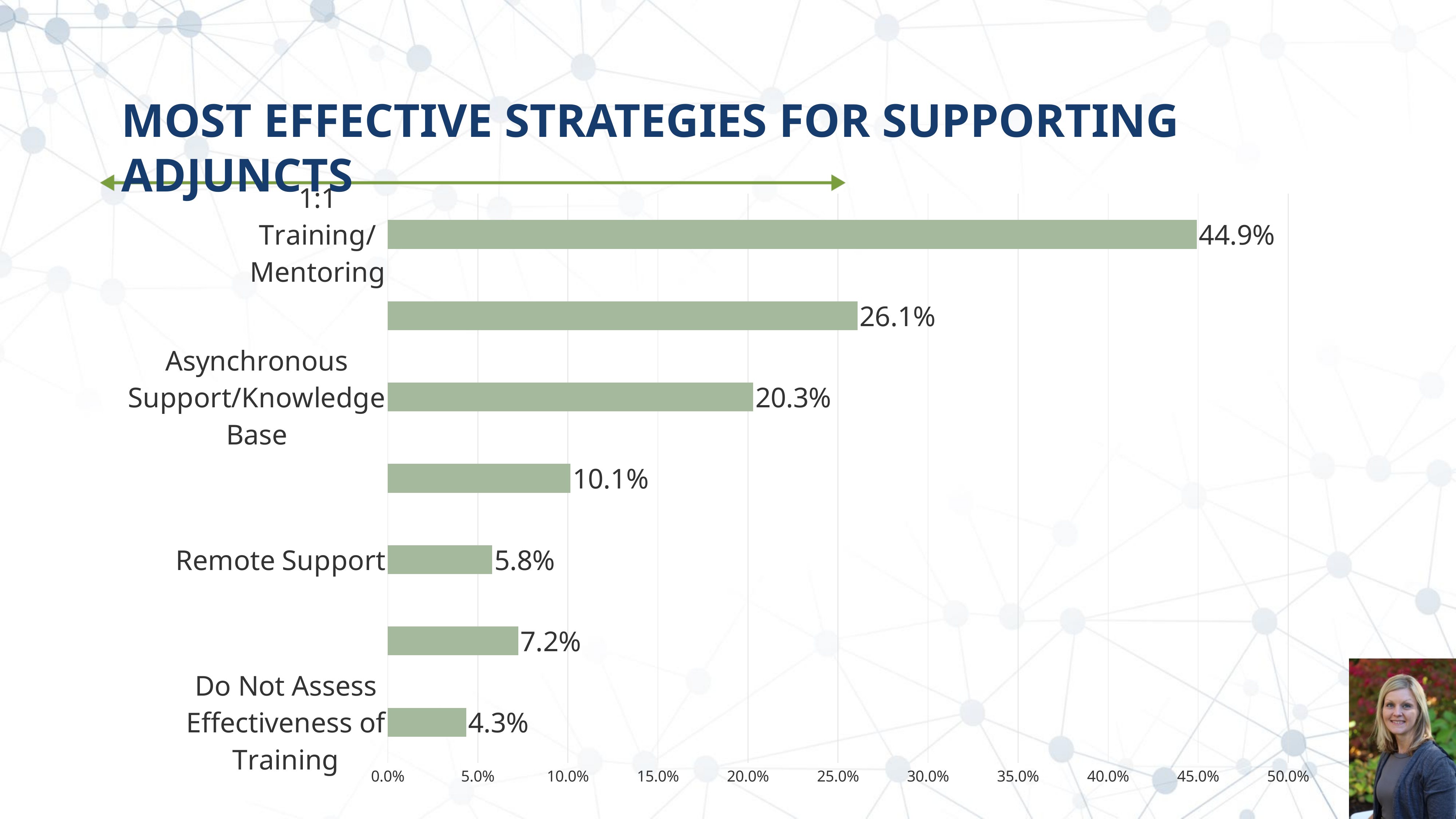
What kind of chart is shown on the slide? bar chart Which is larger, the value for Asynchronous Support/Knowledge Base or the value for Remote Support? Asynchronous Support/Knowledge Base What is the title of the slide containing the chart? MOST EFFECTIVE STRATEGIES FOR SUPPORTING ADJUNCTS What is the value for 1:1 Training/Mentoring? 44.9% What is the difference between the values for 1:1 Training/Mentoring and Asynchronous Support/Knowledge Base? 24.6% How many bars are plotted in the chart? 7 What is the value for Remote Support? 5.8% What is the value for Asynchronous Support/Knowledge Base? 20.3% What is the value for Do Not Assess Effectiveness of Training? 4.3% Which category has the lowest value? Do Not Assess Effectiveness of Training Which category has the highest value? 1:1 Training/Mentoring What is the difference between the values for Remote Support and Do Not Assess Effectiveness of Training? 1.5%